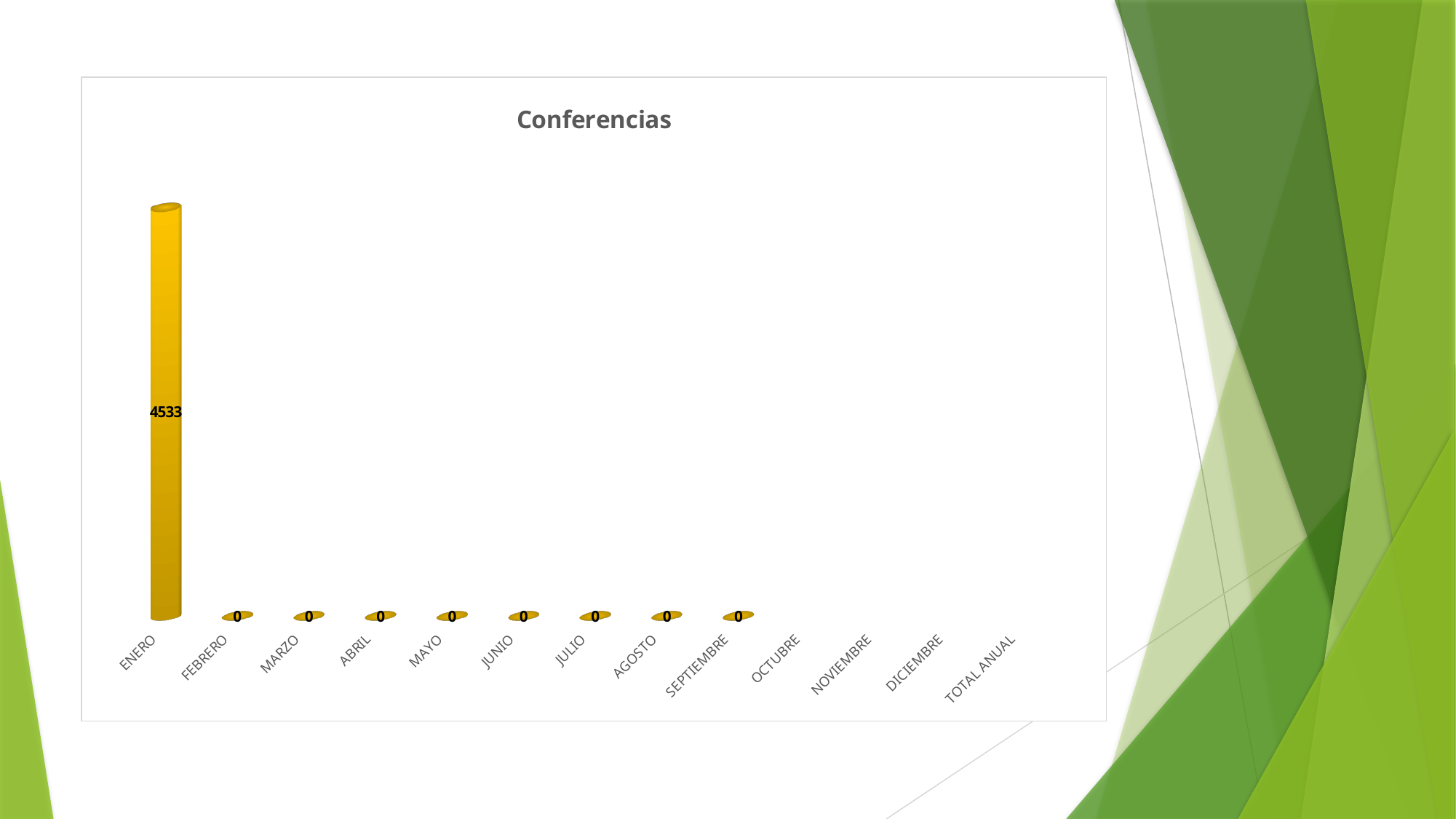
How many category labels are shown on the x axis of the Conferencias chart? 13 Which is larger in the Conferencias chart, the value for ENERO or the value for JULIO? ENERO What is the value for MARZO in the Conferencias chart? 0 What is the difference between the values for ENERO and FEBRERO in the Conferencias chart? 4533 How many categories in the Conferencias chart have a data label of 0? 8 Does the value rise or fall from ENERO to FEBRERO in the Conferencias chart? Fall What kind of chart is shown on the slide? Bar chart What colour are the bars in the Conferencias chart? Yellow/gold What is the value for ENERO in the Conferencias chart? 4533 What is the title of the chart on the slide? Conferencias Which category has the highest value in the Conferencias chart? ENERO What is the value for SEPTIEMBRE in the Conferencias chart? 0